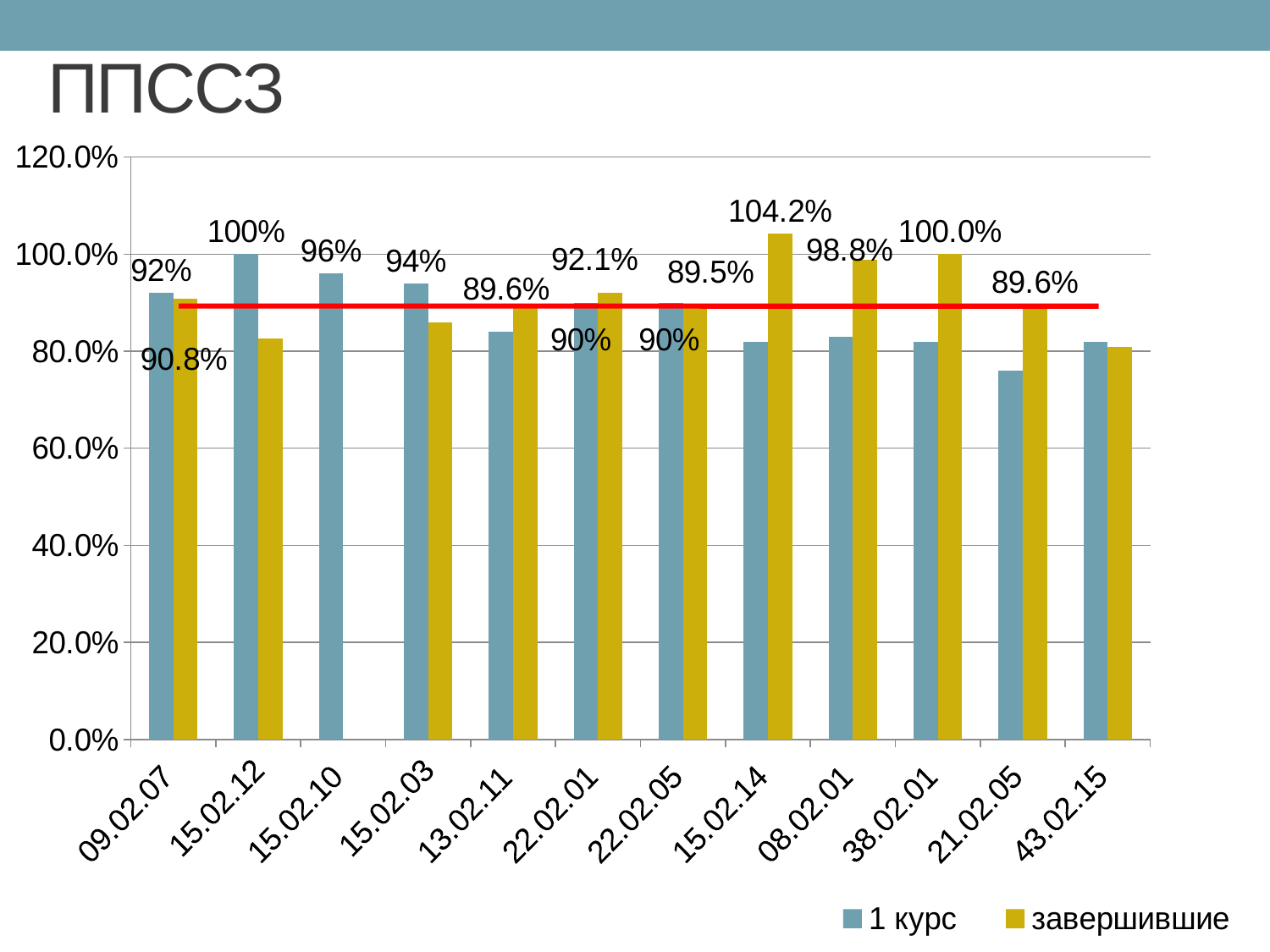
Which category has the highest value for '1 курс'? 15.02.12 What is the value of 'завершившие' for 08.02.01? 98.8% How many categories are shown on the x axis? 12 What is the value of 'завершившие' for 15.02.14? 104.2% What is the value of '1 курс' for 15.02.12? 100% For 22.02.01, what is the difference between 'завершившие' and '1 курс'? 2.1 percentage points Is the value of '1 курс' for 21.02.05 greater or less than 80%? less For 09.02.07, which is larger: '1 курс' or 'завершившие'? 1 курс Which category has the highest value for 'завершившие'? 15.02.14 What is the value of '1 курс' for 09.02.07? 92% How many series does the legend list? 2 What kind of chart is shown on the slide? bar chart